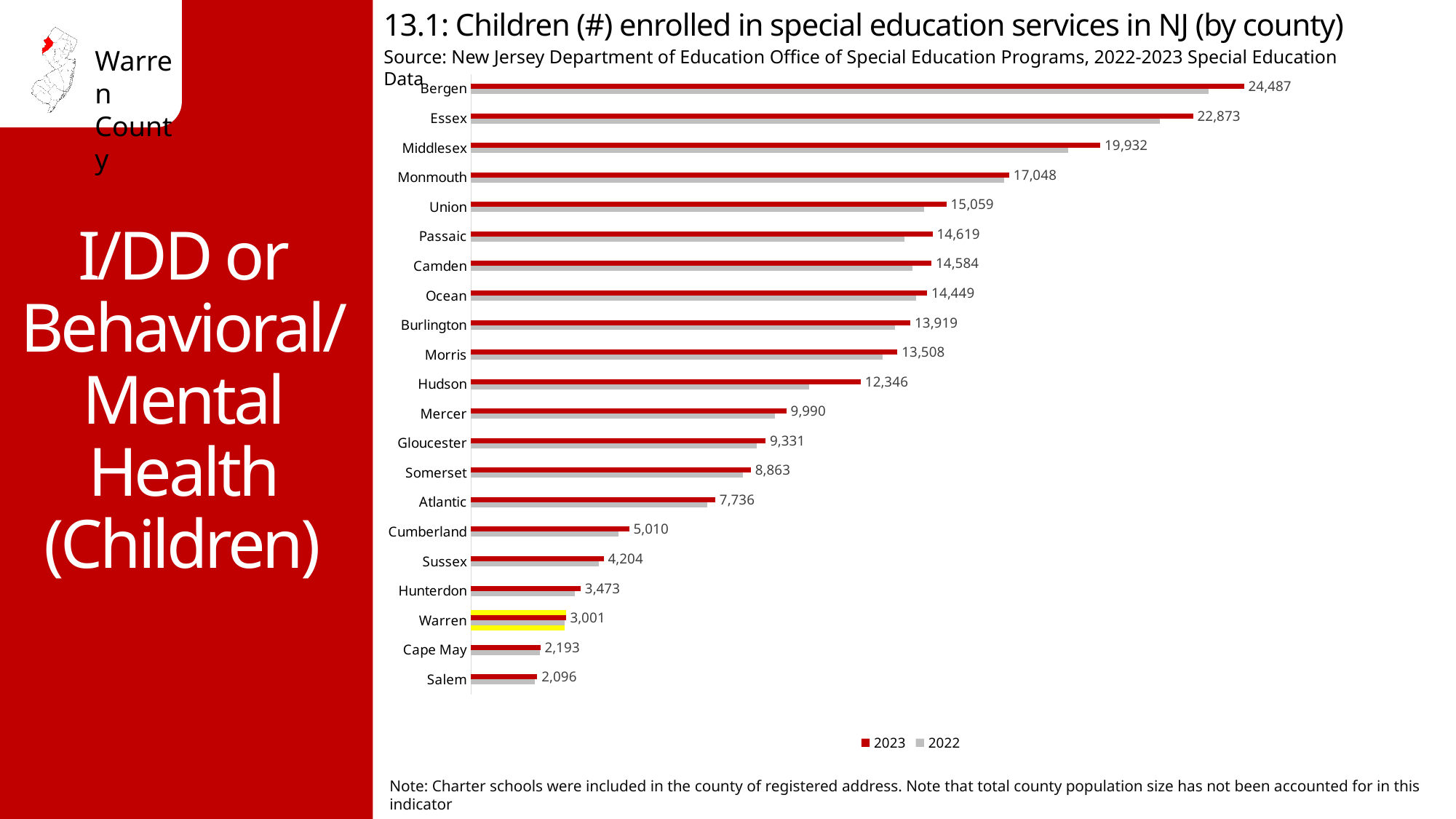
Which county has the larger 2023 value, Hunterdon or Sussex? Sussex What is the 2023 value for Warren county? 3,001 How many counties are shown in the chart? 21 What is the 2023 value for Hudson county? 12,346 Which county has the lowest 2023 value? Salem For Hudson county, is the 2023 bar longer or shorter than the 2022 bar? Longer What is the difference between the 2023 values for Bergen and Essex? 1,614 Which county has the highest 2023 value? Bergen Which series is shown in red in the legend? 2023 What kind of chart is shown on the slide? Bar chart How many series does the legend list? 2 What is the 2023 value for Bergen county? 24,487